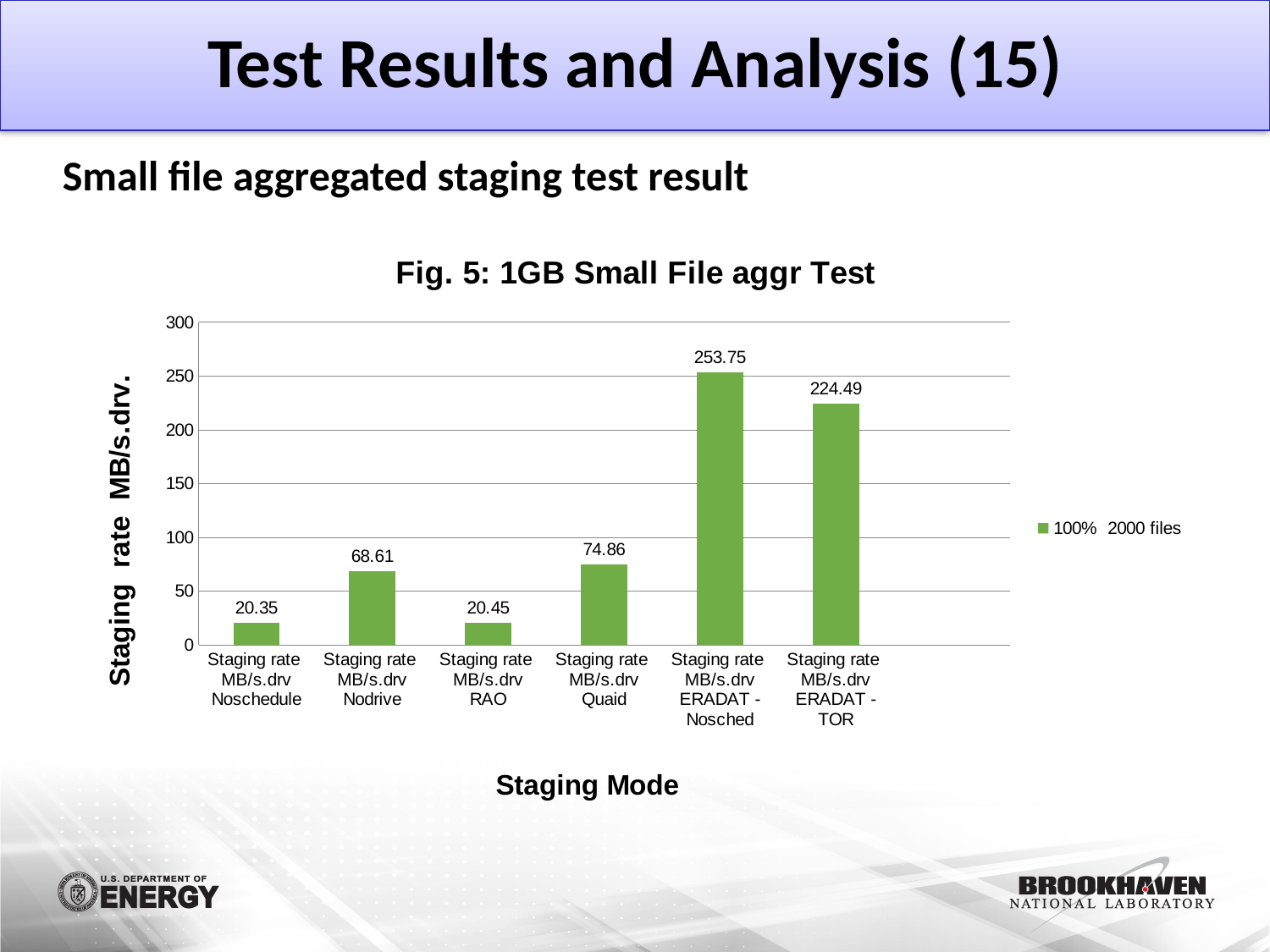
What is the title of the chart? Fig. 5: 1GB Small File aggr Test Which staging mode has the highest staging rate? ERADAT - Nosched Which has a higher staging rate, Nodrive or Quaid? Quaid What is the staging rate for ERADAT - Nosched? 253.75 What is the difference in staging rate between ERADAT - Nosched and ERADAT - TOR? 29.26 How many staging modes are shown on the chart? 6 Is the staging rate for ERADAT - TOR greater or less than 200? greater What is the staging rate for Quaid? 74.86 What is the difference in staging rate between Quaid and Nodrive? 6.25 What kind of chart is shown on the slide? bar chart What is the staging rate for ERADAT - TOR? 224.49 What is the staging rate for Nodrive? 68.61